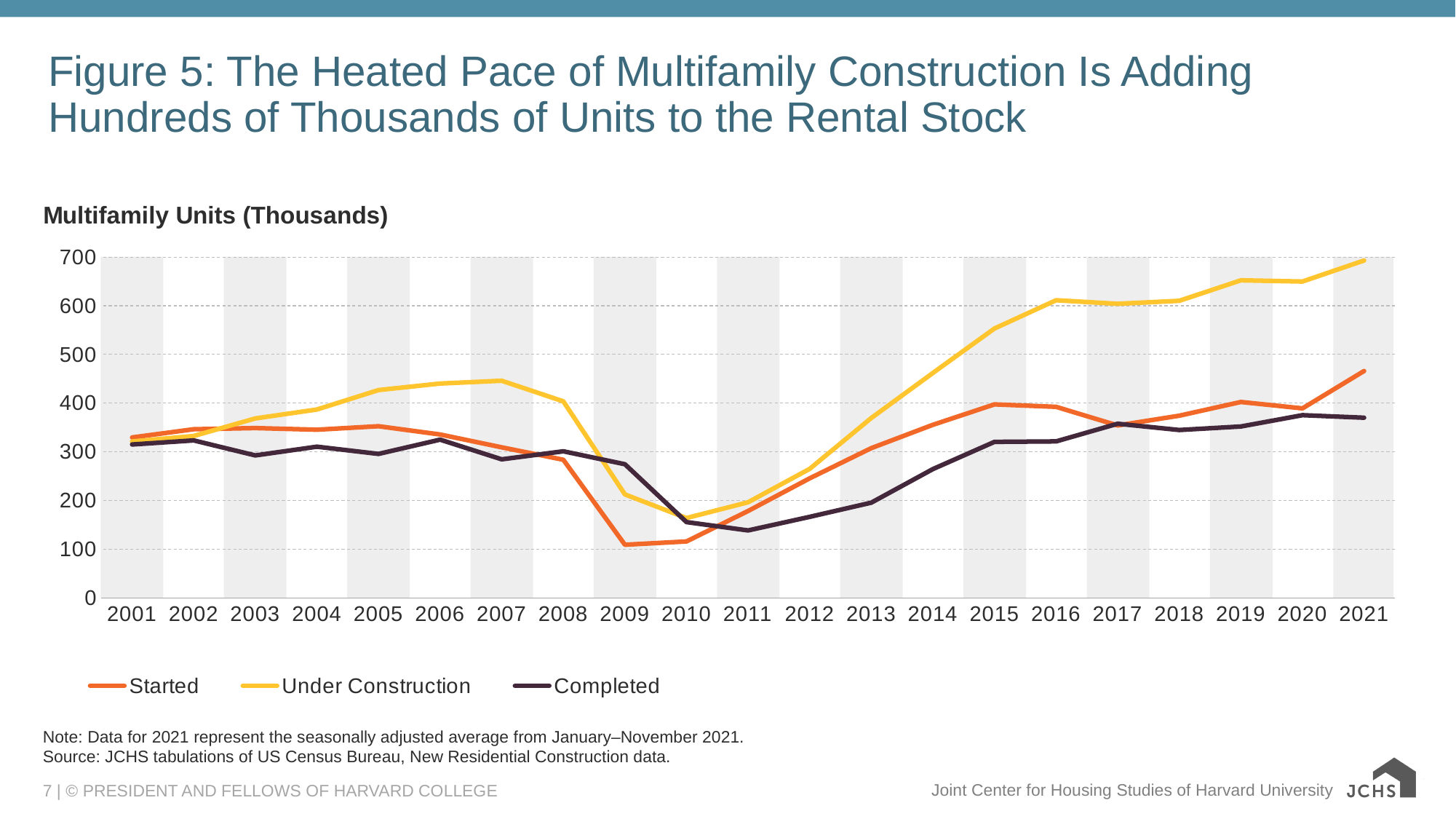
Does the Under Construction series rise or fall from 2011 to 2021? rise Is the value for Completed in 2021 greater or less than 400? less Is the value for Started in 2021 greater or less than 400? greater What kind of chart is shown on the slide? line chart Is the value for Under Construction in 2021 greater or less than 600? greater In which year does the Under Construction series reach its highest value? 2021 In 2009, which is larger: Completed or Started? Completed What is the label above the y axis of the chart? Multifamily Units (Thousands) How many series does the legend list? 3 Which series has the highest value in 2021? Under Construction How many years are shown on the x axis? 21